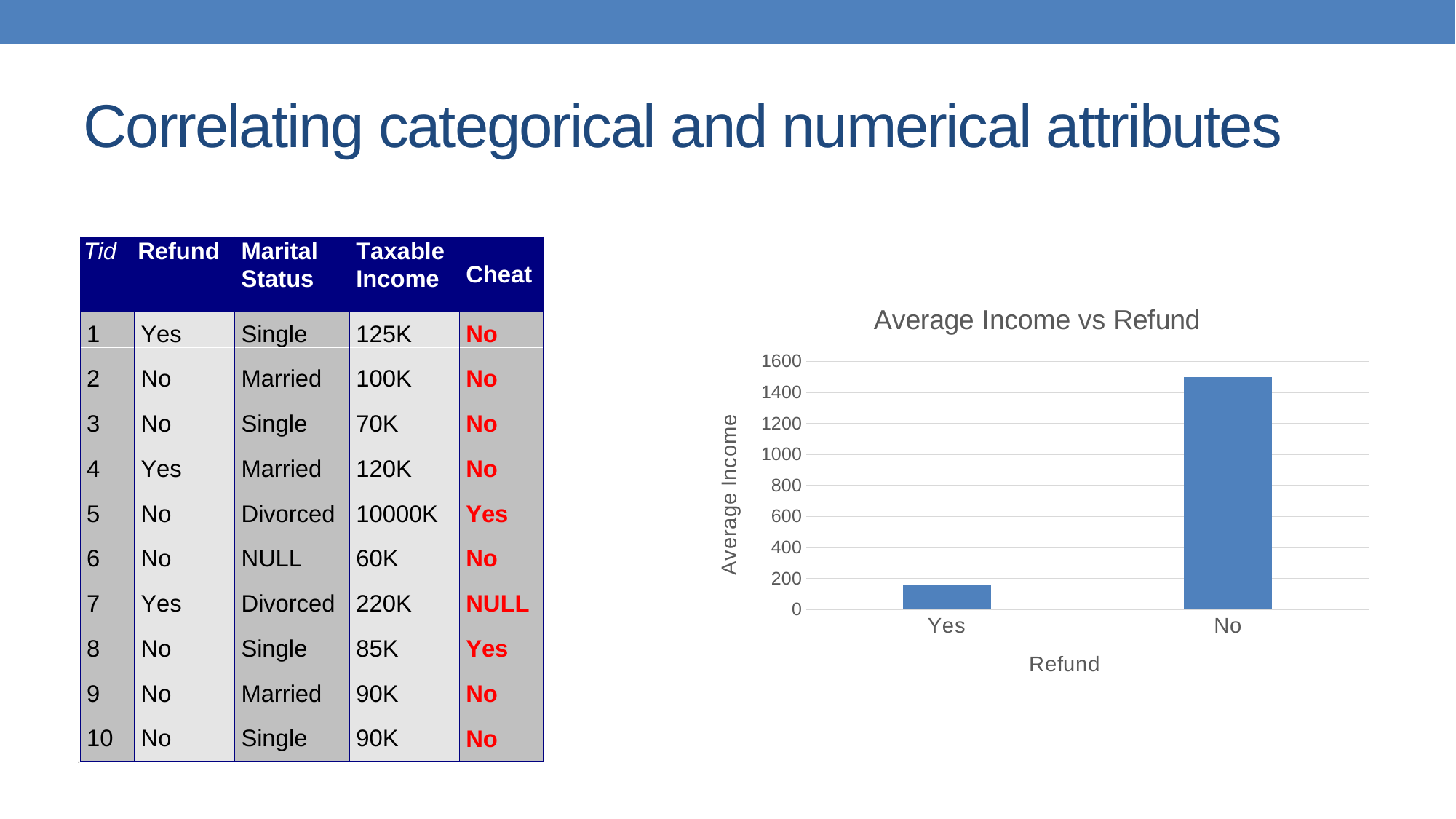
Is the average income for Refund = No greater or less than 1400? greater Which has a larger average income in the chart, Refund = Yes or Refund = No? No What kind of chart is shown on the slide? bar chart Is the average income for Refund = No greater or less than 1000? greater Which Refund category has the lowest average income in the chart? Yes Is the average income for Refund = Yes greater or less than 200? less Which Refund category has the highest average income in the chart? No What is the title of the chart? Average Income vs Refund What is the label on the y axis of the chart? Average Income How many categories are shown on the x axis of the chart? 2